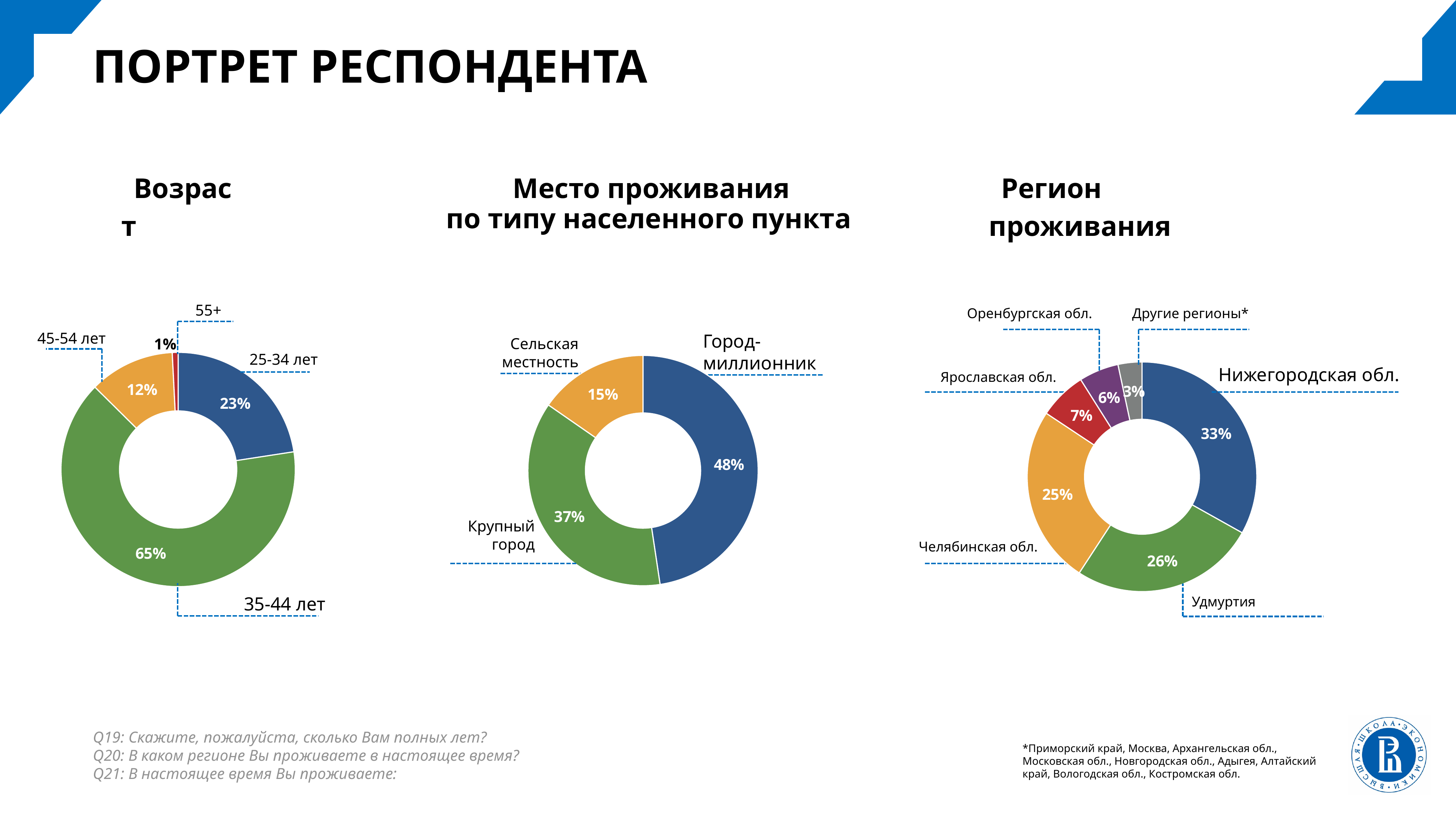
In the 'Место проживания по типу населенного пункта' chart, which is larger: Крупный город or Сельская местность? Крупный город How many regions (categories) does the 'Регион проживания' chart show? 6 In the 'Место проживания по типу населенного пункта' chart, which category has the lowest share? Сельская местность In the 'Возраст' chart, which age group has the smallest share? 55+ In the 'Регион проживания' chart, what share of respondents live in Челябинская обл.? 25% What type of chart is the 'Место проживания по типу населенного пункта' chart? Donut (pie) chart In the 'Регион проживания' chart, which region has the largest share? Нижегородская обл. In the 'Возраст' chart, what share of respondents are aged 35-44 лет? 65% How many categories does the 'Возраст' chart show? 4 In the 'Возраст' chart, what is the difference between the shares for 25-34 лет and 45-54 лет? 11% In the 'Место проживания по типу населенного пункта' chart, what share of respondents live in a Город-миллионник? 48% In the 'Регион проживания' chart, what is the difference between the shares for Нижегородская обл. and Удмуртия? 7%